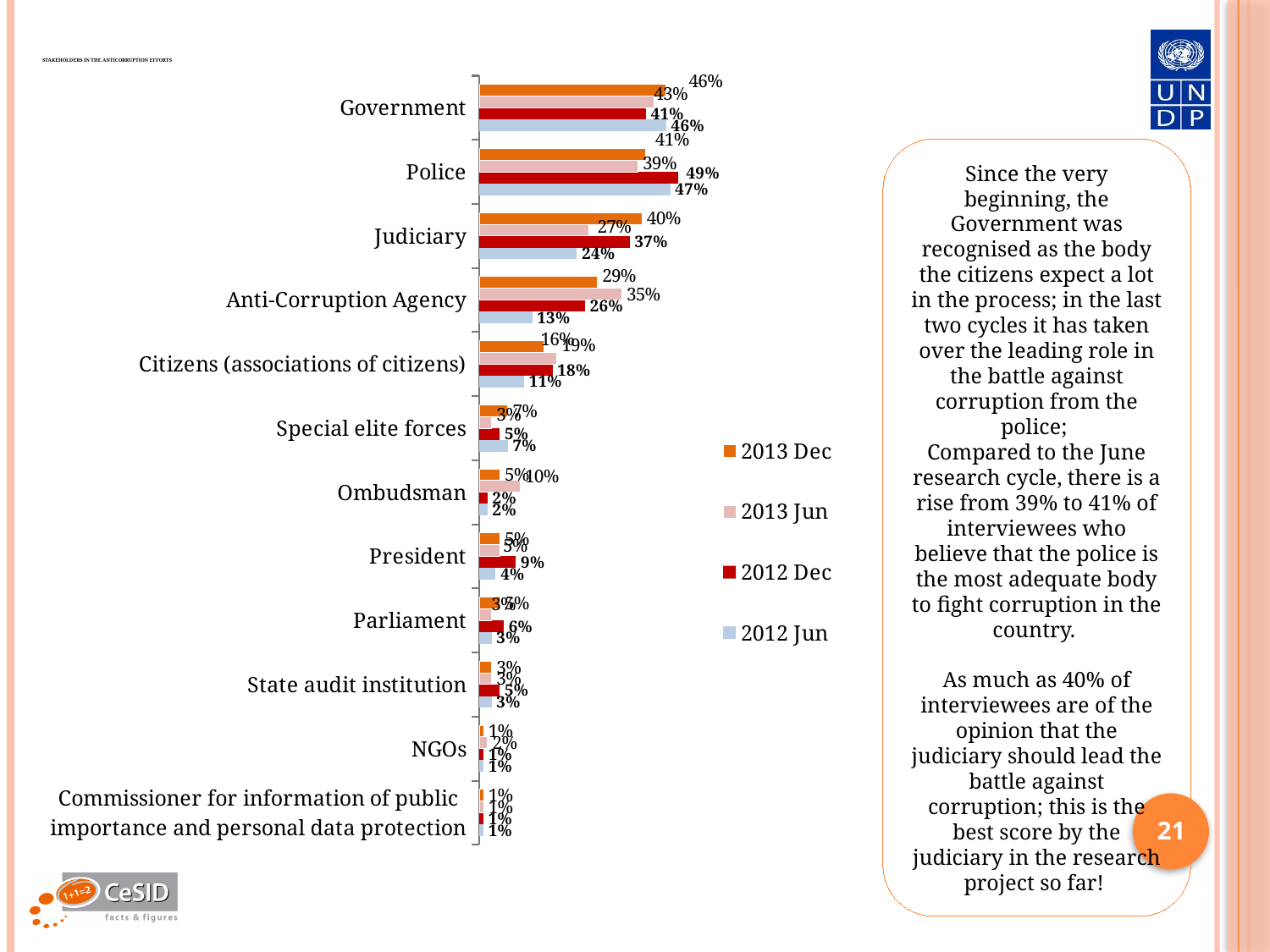
What is the value for Judiciary in the 2013 Dec series? 40% Which series is shown in orange in the legend? 2013 Dec For Judiciary, which is larger: the 2013 Dec value or the 2013 Jun value? 2013 Dec Which category has the highest value in the 2012 Dec series? Police What is the value for Ombudsman in the 2013 Jun series? 10% What is the difference between the Police values for 2012 Dec and 2012 Jun? 2 percentage points What is the value for Anti-Corruption Agency in the 2012 Jun series? 13% What is the value for Anti-Corruption Agency in the 2013 Jun series? 35% How many series does the legend list? 4 What is the value for Police in the 2012 Dec series? 49% What kind of chart is shown on the slide? Bar chart How many categories (stakeholders) are plotted on the chart? 12